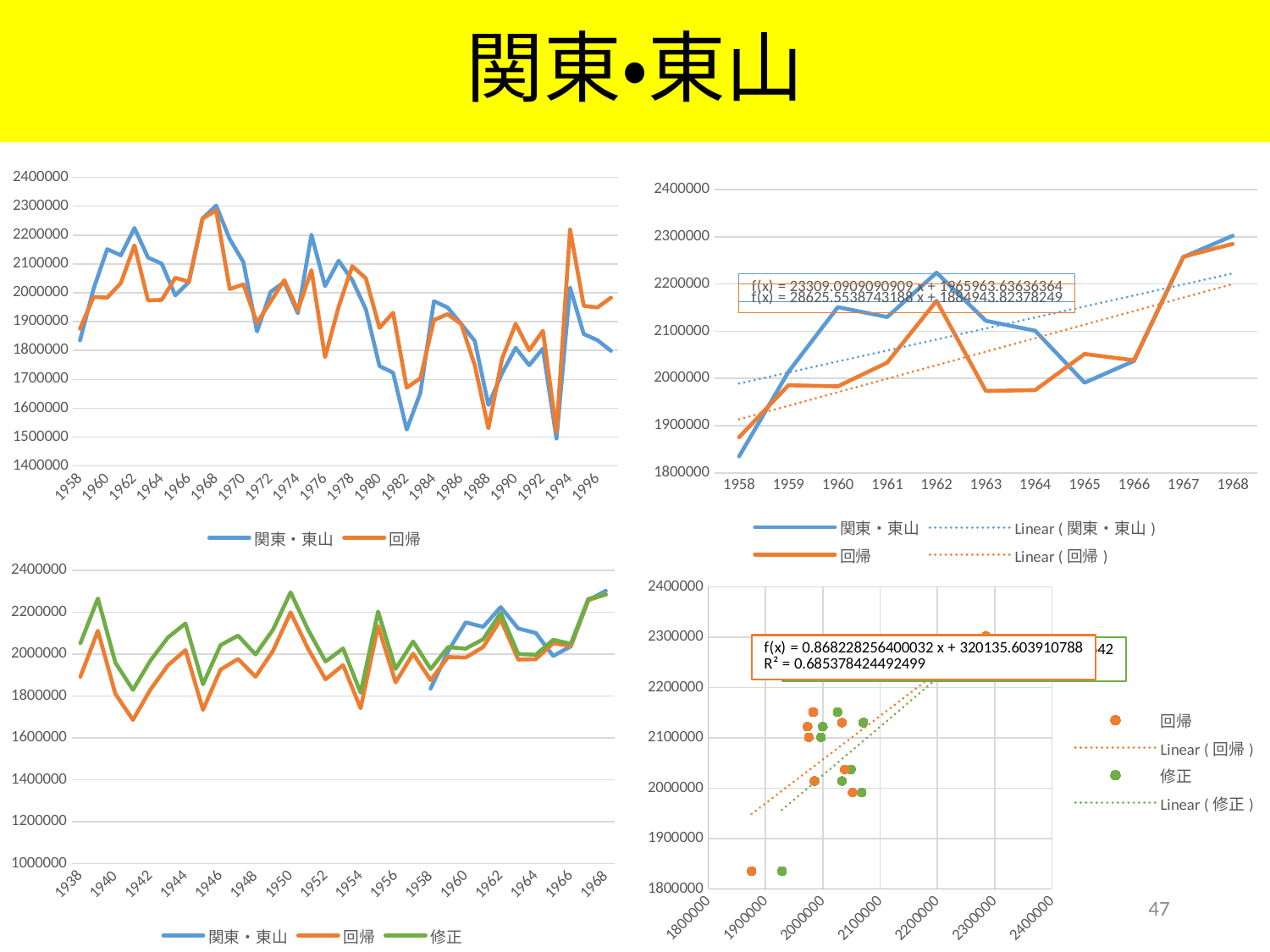
In the top-left chart, is the value for 関東・東山 in 1982 greater or less than 1600000? less In the bottom-left chart, is the value for 修正 in 1950 greater or less than 2200000? greater In the top-right chart, which year has the highest value for 関東・東山? 1968 In the bottom-right chart, what R² value is printed in the equation box? 0.685378424492499 In the top-right chart, how many years are shown on the x axis? 11 In the top-right chart, which series has the larger value in 1962, 関東・東山 or 回帰? 関東・東山 How many series does the legend of the bottom-left chart list? 3 What kind of chart is the bottom-right chart on the slide? scatter chart In the top-right chart, is the value for 回帰 in 1963 greater or less than 2000000? less How many entries does the legend of the top-right chart list? 4 What kind of chart is the top-left chart on the slide? line chart In the top-right chart, which year has the lowest value for 関東・東山? 1958